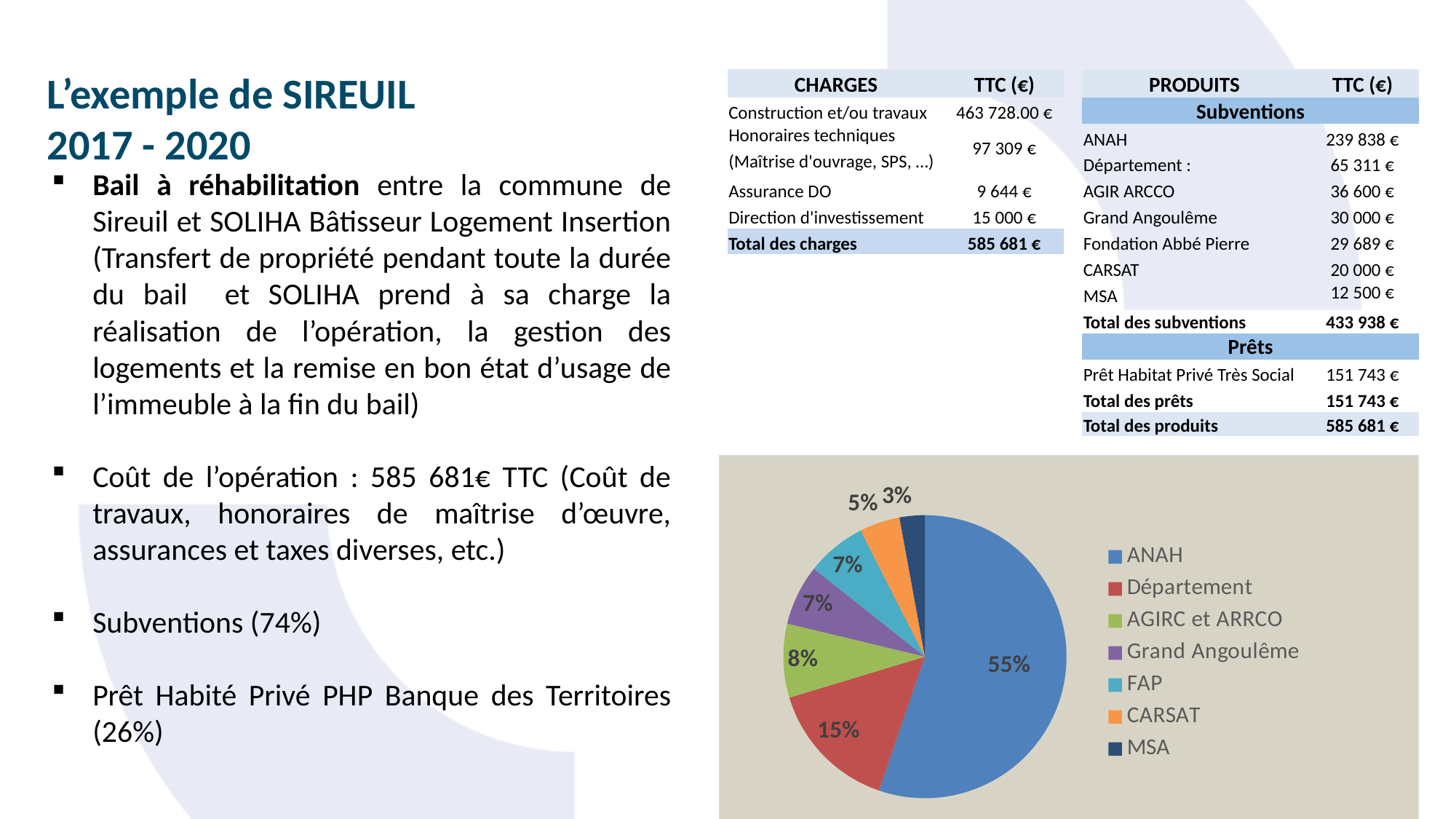
What kind of chart is shown on the slide? pie chart Which category has the smallest slice of the pie? MSA What share of the pie does MSA represent? 3% Which category has the largest slice of the pie? ANAH What share of the pie does AGIRC et ARRCO represent? 8% What share of the pie does CARSAT represent? 5% What is the difference in percentage points between the ANAH slice and the Département slice? 40 Which slice is larger, Département or AGIRC et ARRCO? Département How many categories does the pie chart show? 7 What colour is the ANAH slice in the pie chart? blue